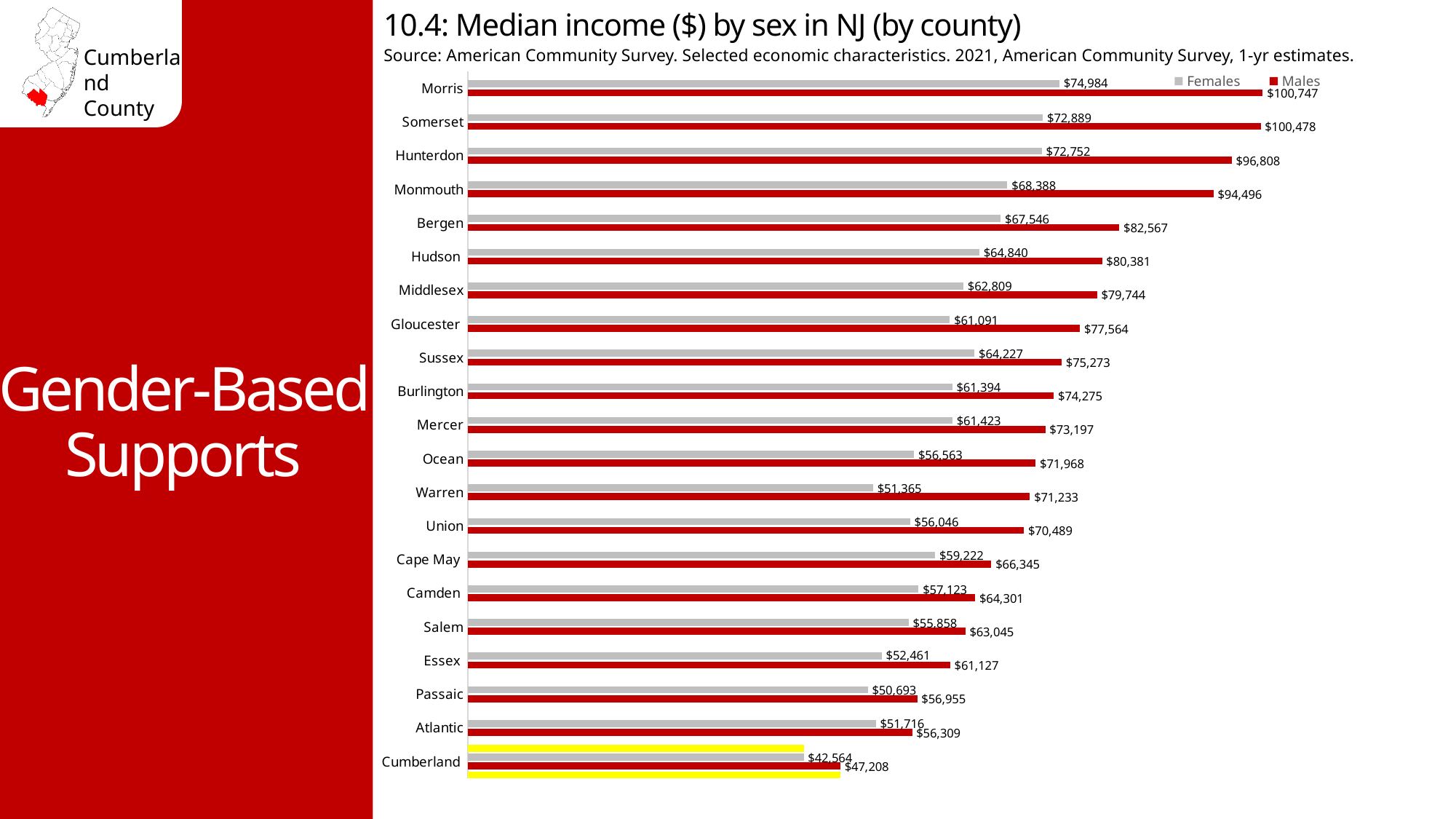
What type of chart is shown on the slide? Bar chart How many series does the legend list? 2 What is the difference between male and female median income in Morris County? $25,763 What is the difference between male and female median income in Cumberland County? $4,644 Which is larger, the female median income in Sussex County or in Gloucester County? Sussex Which county has the lowest median income for females? Cumberland What is the median income for males in Cumberland County? $47,208 Which county has the highest median income for males? Morris What is the median income for females in Morris County? $74,984 What is the median income for females in Warren County? $51,365 What is the median income for males in Hunterdon County? $96,808 How many counties are shown in the chart? 21